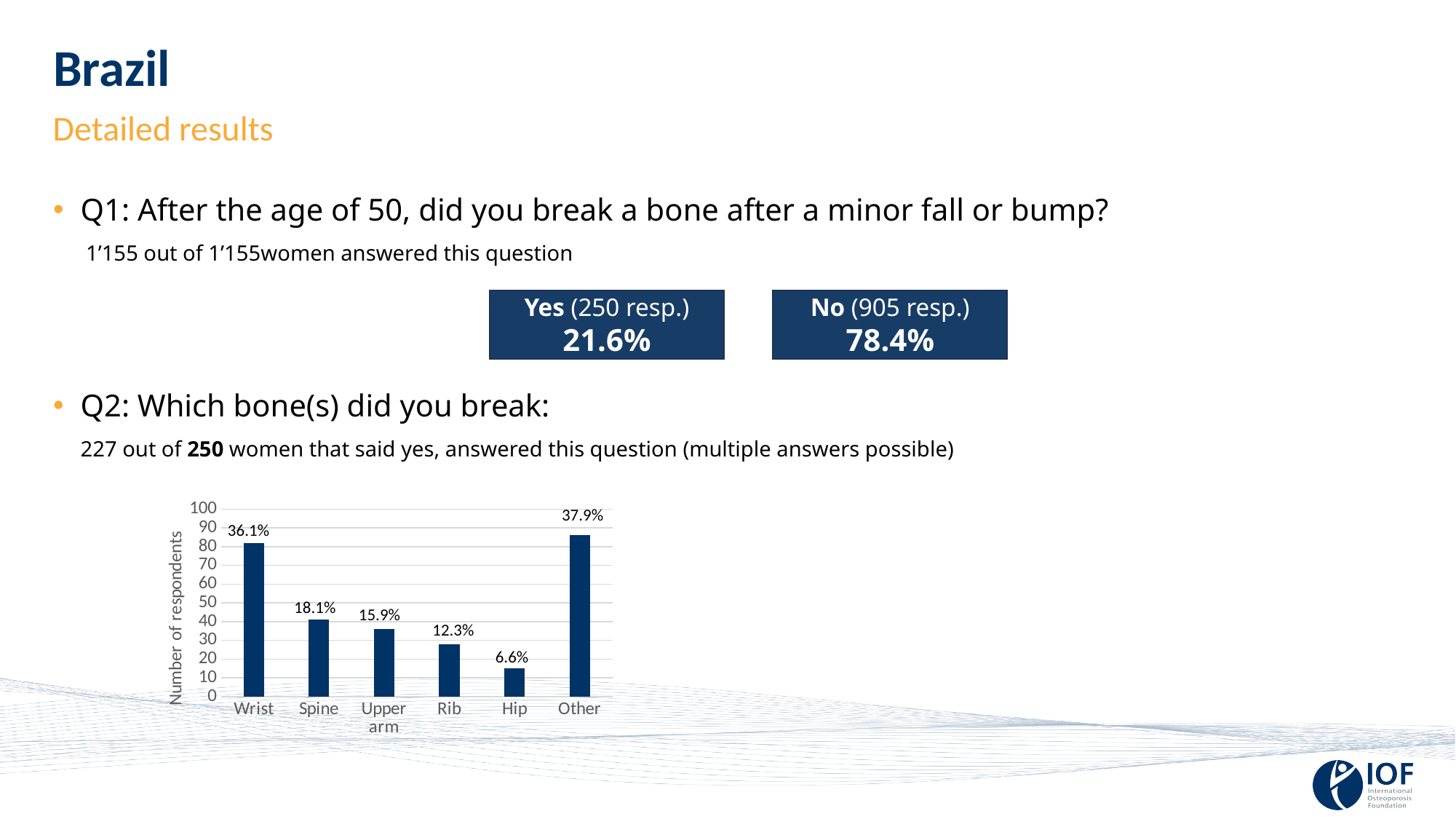
What percentage label is shown above the Hip bar in the chart? 6.6% Is the number of respondents for Spine greater or less than 50? less What percentage label is shown above the Rib bar in the chart? 12.3% Is the number of respondents for Wrist greater or less than 70? greater What type of chart is used to show which bones were broken? Bar chart What percentage label is shown above the Wrist bar in the chart? 36.1% What is the label of the vertical axis of the chart? Number of respondents What is the difference in percentage points between the labels for Other and Wrist? 1.8 Which category in the chart has the highest value? Other Which category in the chart has the lowest value? Hip How many bone categories are shown in the chart? 6 Which has a larger value in the chart, Spine or Upper arm? Spine